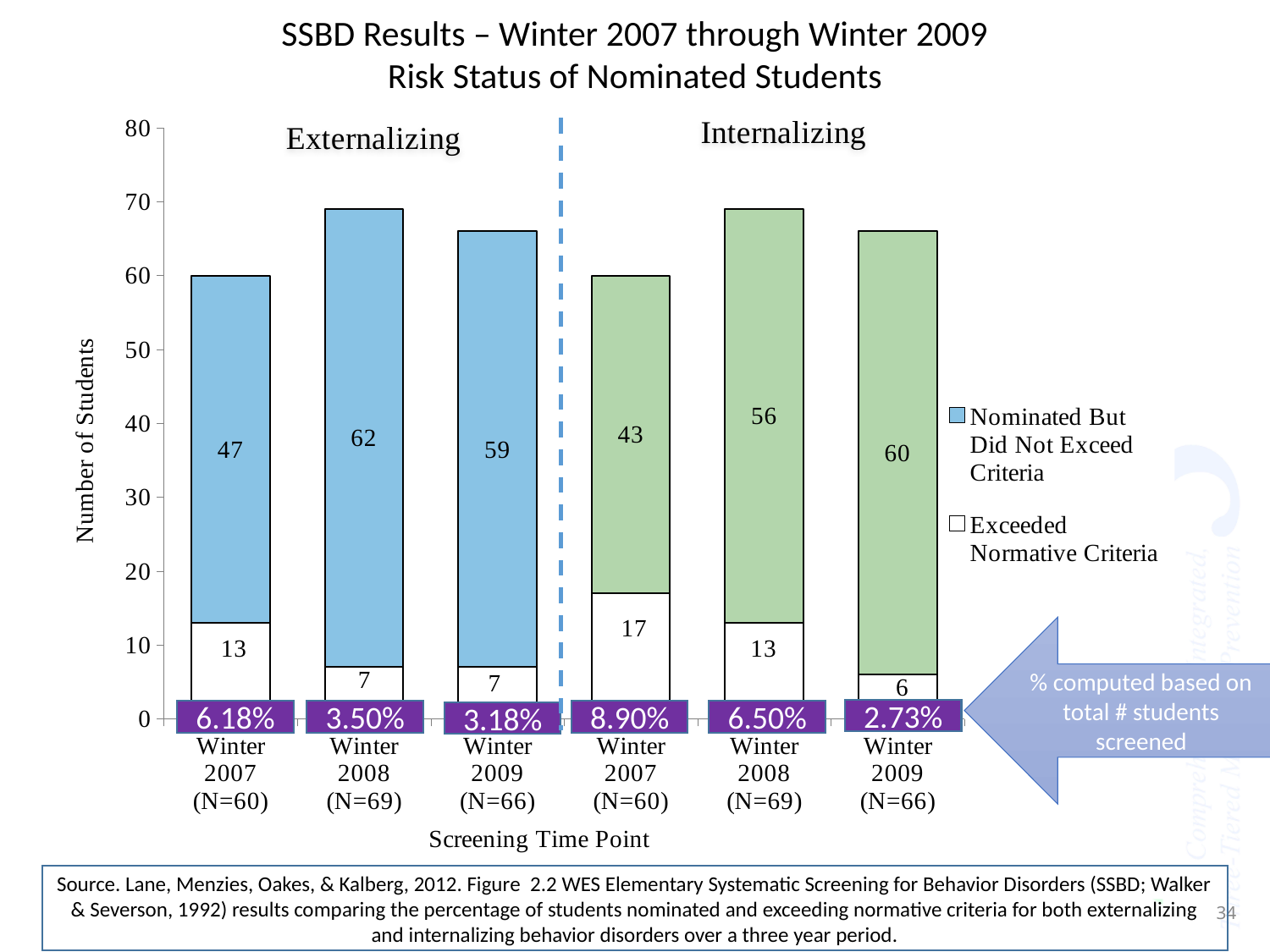
How many series does the legend list? 2 How many students were in the "Exceeded Normative Criteria" group for Externalizing in Winter 2007? 13 What percentage is shown below the Internalizing Winter 2007 bar? 8.90% Which bar has the highest number of students who exceeded normative criteria? Internalizing Winter 2007 How many students were "Nominated But Did Not Exceed Criteria" for Internalizing in Winter 2008? 56 What is the total number of students in the Externalizing Winter 2008 bar? 69 How many bars are plotted in the chart? 6 Which is larger: the "Exceeded Normative Criteria" value for Internalizing Winter 2008 or for Externalizing Winter 2009? Internalizing Winter 2008 Which bar has the lowest number of students who exceeded normative criteria? Internalizing Winter 2009 What is the label of the y axis? Number of Students What kind of chart is shown on the slide? Stacked bar chart What is the difference between the "Nominated But Did Not Exceed Criteria" values for Externalizing Winter 2008 and Externalizing Winter 2007? 15